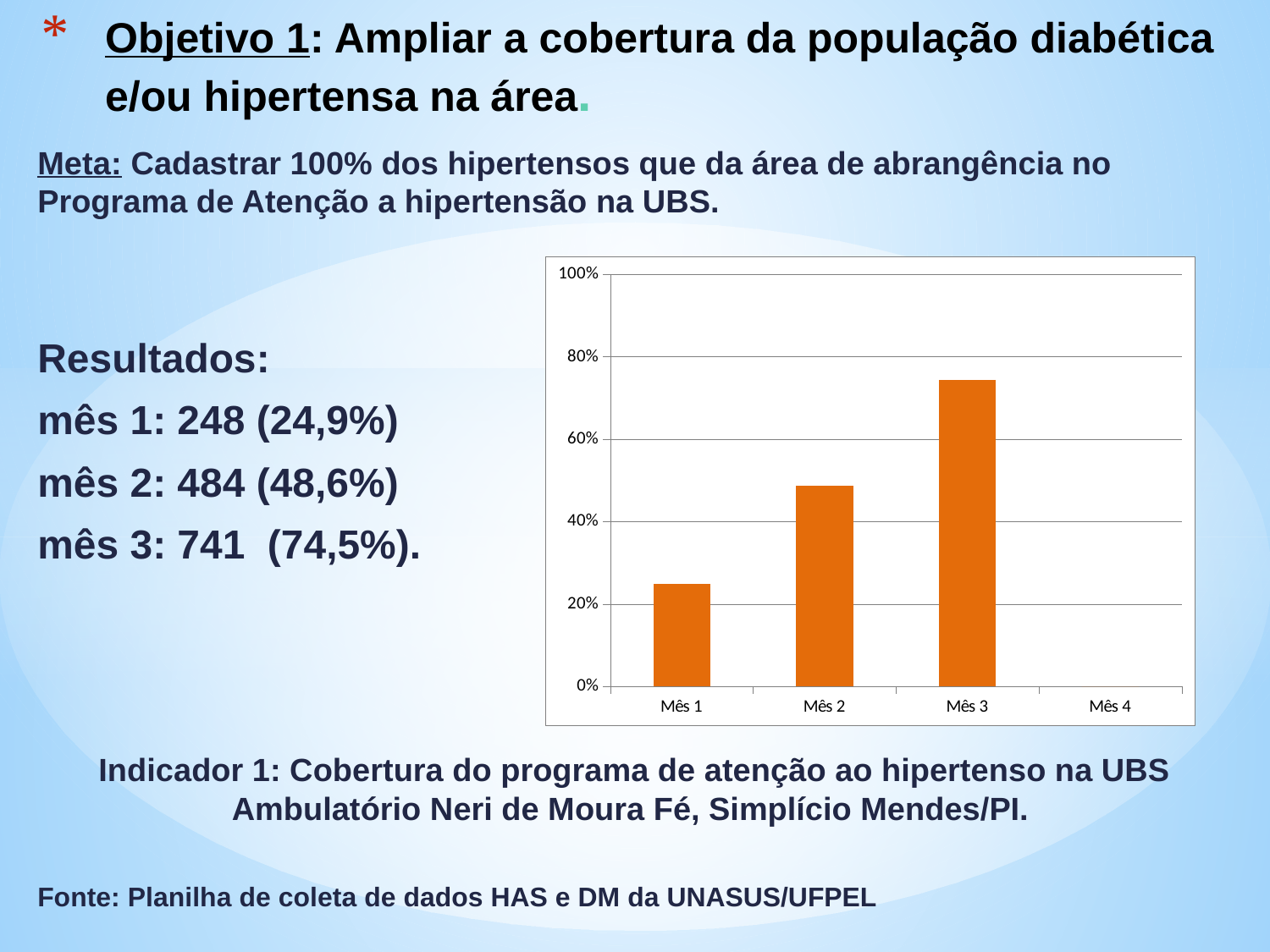
Is the value for Mês 2 greater or less than 40%? greater Is the value for Mês 1 greater or less than 40%? less Which is larger, the value for Mês 2 or the value for Mês 3? Mês 3 Among the months with a plotted bar, which has the lowest value? Mês 1 What kind of chart is shown on the slide? bar chart How many categories are labelled on the x axis of the chart? 4 Which month has the highest bar in the chart? Mês 3 What is the highest tick value shown on the y axis of the chart? 100% Is the value for Mês 3 greater or less than 60%? greater Do the bar values rise or fall from Mês 1 to Mês 3? rise According to the results text on the slide, what coverage percentage corresponds to the Mês 3 bar? 74,5% How many bars are actually plotted in the chart? 3